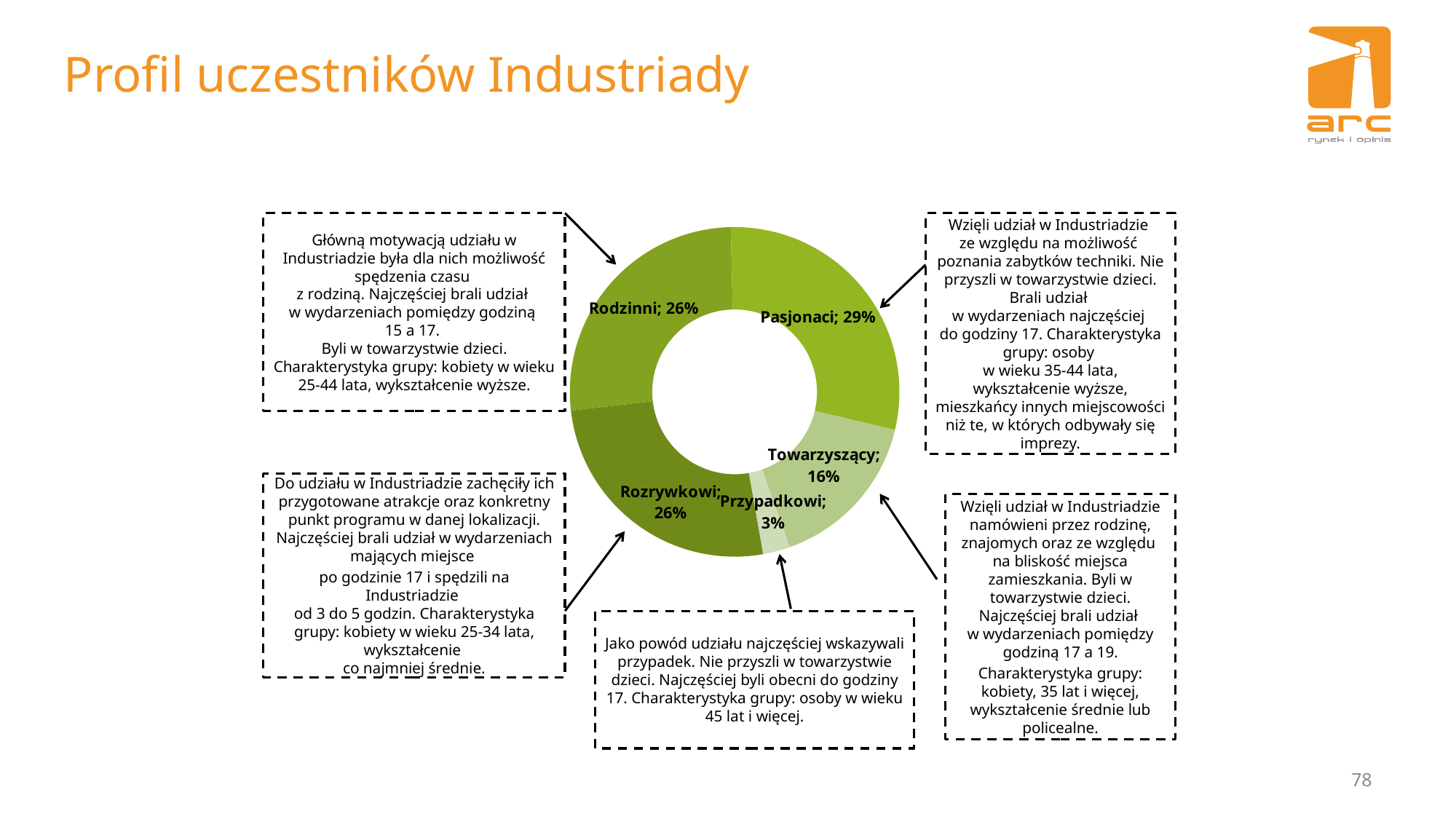
What share of participants is labelled Pasjonaci? 29% What percentage is shown for the Rozrywkowi segment? 26% What percentage is shown for the Przypadkowi segment? 3% What is the combined share of the Rodzinni and Rozrywkowi segments? 52% Which segment has the largest share? Pasjonaci How many segments does the chart have? 5 What is the difference in percentage points between Pasjonaci and Towarzyszący? 13 What kind of chart is shown on the slide? doughnut chart Which is larger, the Towarzyszący segment or the Przypadkowi segment? Towarzyszący What percentage is shown for the Towarzyszący segment? 16% Which segment has the smallest share? Przypadkowi What percentage is shown for the Rodzinni segment? 26%